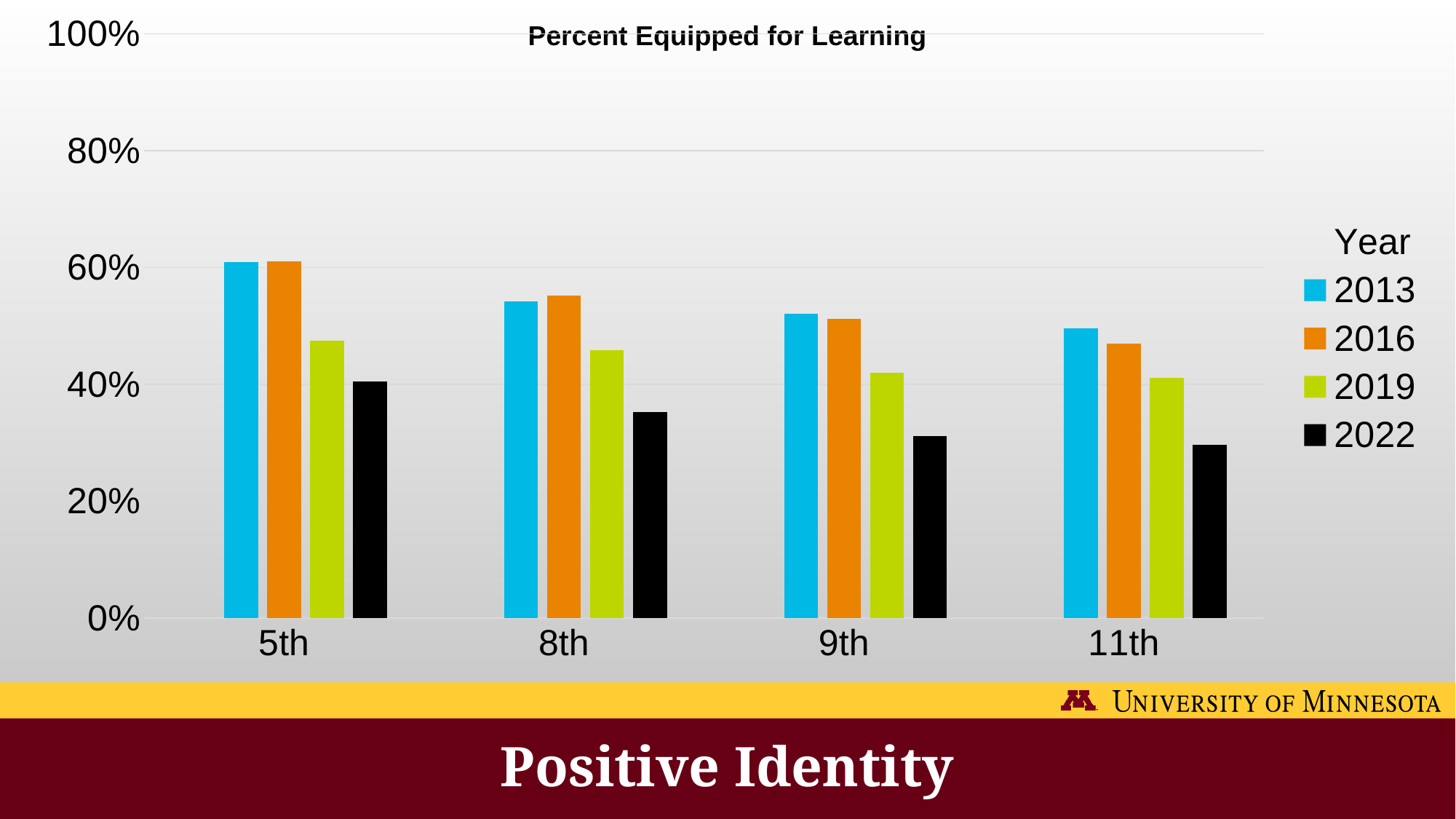
What kind of chart is shown on the slide? bar chart Do the values for the 2022 series rise or fall from 5th grade to 11th grade? fall How many series does the legend list? 4 How many grade categories are shown on the x axis? 4 Is the value for 2022 in 11th grade greater or less than 20%? greater Is the value for 2019 in 5th grade greater or less than 60%? less Which colour represents the 2022 series in the legend? black For 11th grade, which is larger: the value for 2019 or the value for 2022? 2019 Which year has the lowest value for 9th grade? 2022 What is the title of the chart? Percent Equipped for Learning Is the value for 2022 in 8th grade greater or less than 40%? less